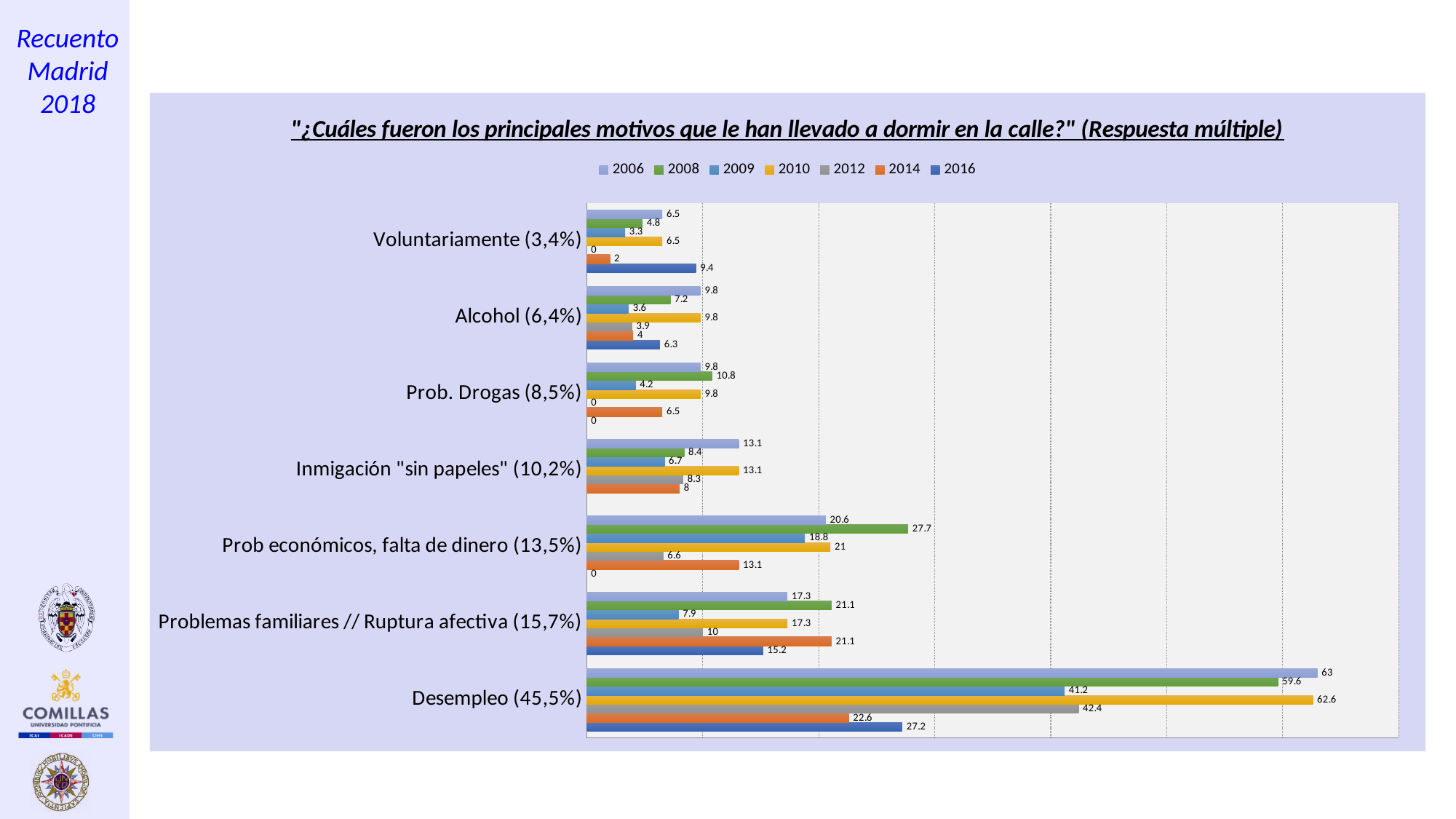
What is the difference between the 2006 and 2016 values for Desempleo (45,5%)? 35.8 Which series has the lowest value for Desempleo (45,5%)? 2014 How many categories are shown on the y axis? 7 Which year does the orange series in the legend represent? 2014 Which category has the highest value in the 2010 series? Desempleo (45,5%) How many series does the legend list? 7 What is the value for Desempleo (45,5%) in the 2006 series? 63 Which is larger for Alcohol (6,4%): the 2008 value or the 2016 value? 2008 What is the value for Voluntariamente (3,4%) in the 2016 series? 9.4 What is the value for Problemas familiares // Ruptura afectiva (15,7%) in the 2014 series? 21.1 What kind of chart is shown on the slide? Bar chart What is the value for Prob económicos, falta de dinero (13,5%) in the 2008 series? 27.7